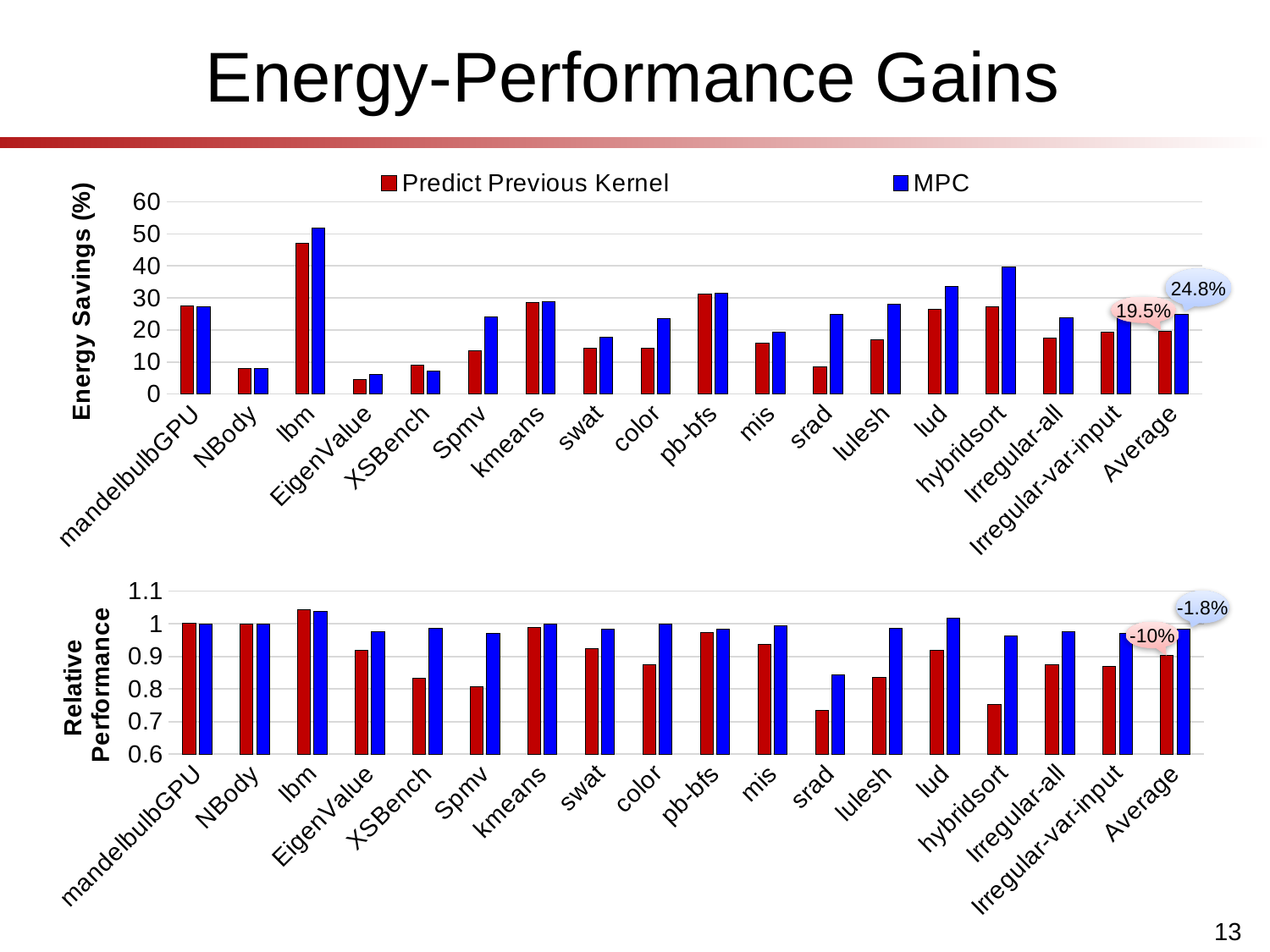
In the bottom chart (Relative Performance), is the Predict Previous Kernel value for srad greater or less than 0.8? less In the top chart (Energy Savings), what value is labelled for the Average MPC bar? 24.8% How many series does the legend of the top chart list? 2 In the top chart (Energy Savings), which category has the lowest Predict Previous Kernel value? EigenValue In the top chart (Energy Savings), what is the difference between the labelled Average values for MPC and Predict Previous Kernel? 5.3 percentage points In the top chart (Energy Savings), what value is labelled for the Average Predict Previous Kernel bar? 19.5% How many benchmark categories are shown along the x axis of the top chart (Energy Savings)? 18 In the top chart (Energy Savings), which category has the highest MPC value? lbm In the top chart (Energy Savings), is the MPC value for hybridsort greater or less than 30? greater What kind of chart is the top chart (Energy Savings)? bar chart In the bottom chart (Relative Performance), which series is drawn in blue? MPC In the top chart (Energy Savings), which is larger for srad: the MPC value or the Predict Previous Kernel value? MPC